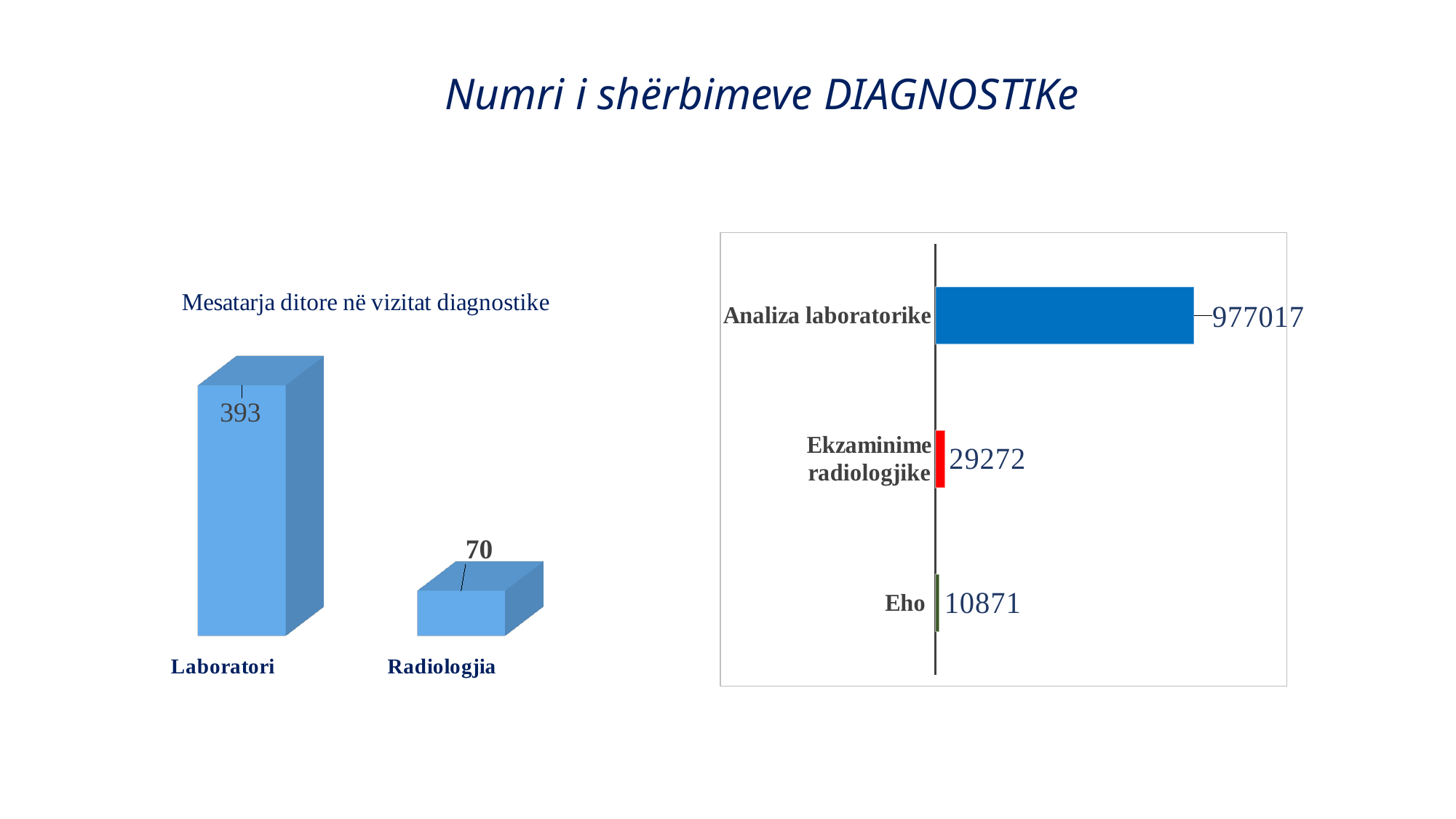
In the chart titled 'Mesatarja ditore në vizitat diagnostike', what is the difference between Laboratori and Radiologjia? 323 In the chart on the right of the slide, what is the value for Ekzaminime radiologjike? 29272 In the chart on the right of the slide, what is the value for Eho? 10871 In the chart on the right of the slide, what is the difference between Ekzaminime radiologjike and Eho? 18401 In the chart titled 'Mesatarja ditore në vizitat diagnostike', which category has the highest value? Laboratori In the chart on the right of the slide, which category has the lowest value? Eho In the chart titled 'Mesatarja ditore në vizitat diagnostike', what is the value for Radiologjia? 70 In the chart titled 'Mesatarja ditore në vizitat diagnostike', what is the value for Laboratori? 393 In the chart titled 'Mesatarja ditore në vizitat diagnostike', how many categories are shown? 2 In the chart on the right of the slide, how many categories are shown? 3 In the chart on the right of the slide, what is the value for Analiza laboratorike? 977017 What kind of chart is the one on the left of the slide? Bar chart